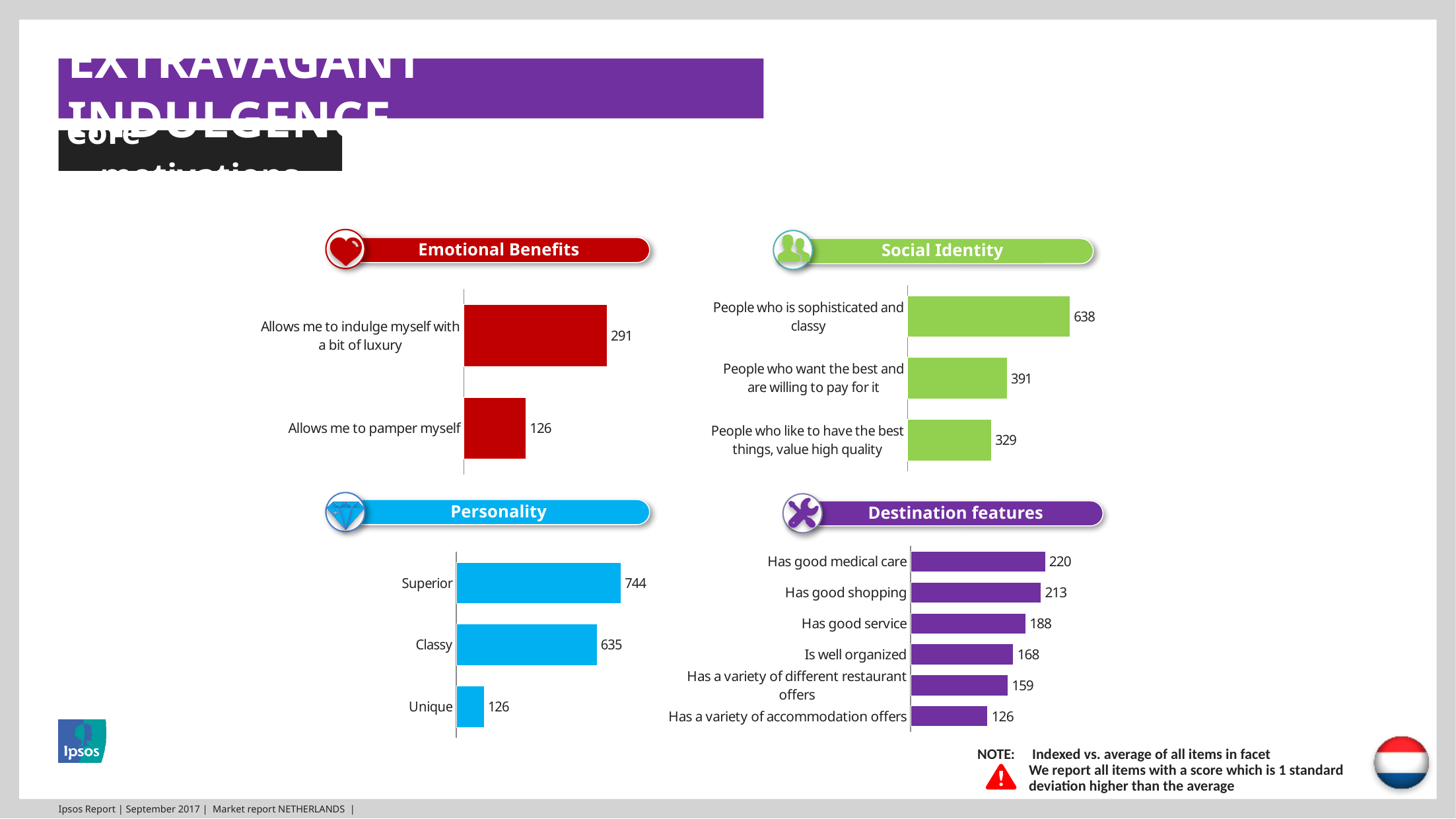
In the Social Identity chart, how many categories are shown? 3 In the Destination features chart, how many categories are shown? 6 What type of chart is the Destination features chart? Bar chart In the Destination features chart, what is the value for "Is well organized"? 168 In the Social Identity chart, what is the value for "People who like to have the best things, value high quality"? 329 In the Social Identity chart, which category has the highest value? People who is sophisticated and classy In the Personality chart, what is the value for Classy? 635 In the Emotional Benefits chart, what is the difference between the two bars? 165 In the Emotional Benefits chart, what is the value for "Allows me to indulge myself with a bit of luxury"? 291 In the Personality chart, what is the difference between Superior and Classy? 109 In the Destination features chart, which is larger: "Has good medical care" or "Has good shopping"? Has good medical care In the Personality chart, which category has the lowest value? Unique